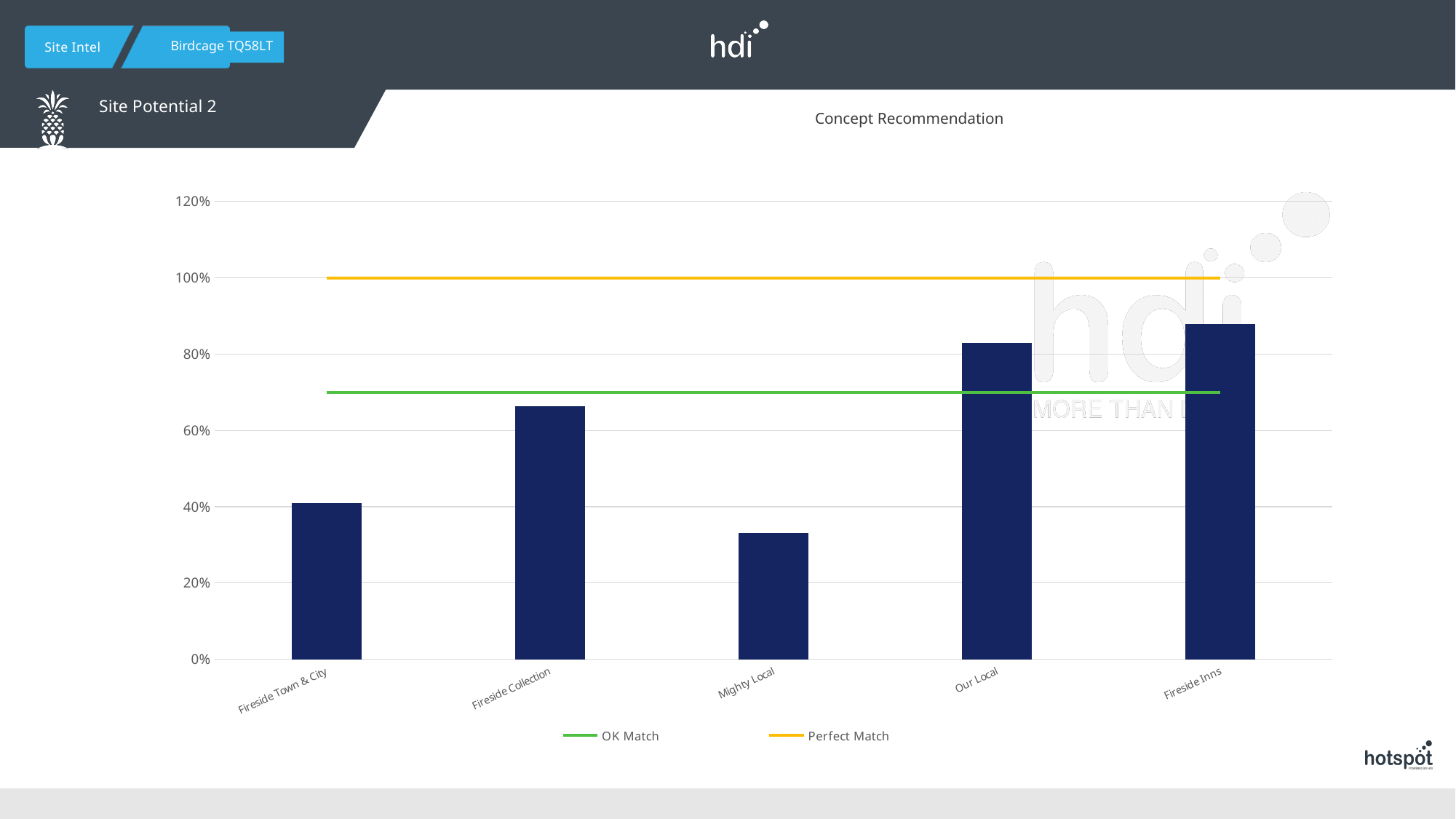
What is the title of the chart? Concept Recommendation Which is larger, the value for Fireside Collection or the value for Fireside Town & City? Fireside Collection How many concept categories are plotted on the x axis? 5 What kind of chart is shown on the slide? bar chart Is the value for Fireside Collection greater or less than 60%? greater Which concept has the highest bar? Fireside Inns Which concept has the lowest bar? Mighty Local At what level is the Perfect Match line drawn? 100% Is the value for Fireside Town & City greater or less than 60%? less Is the value for Mighty Local greater or less than 40%? less How many entries does the legend list? 2